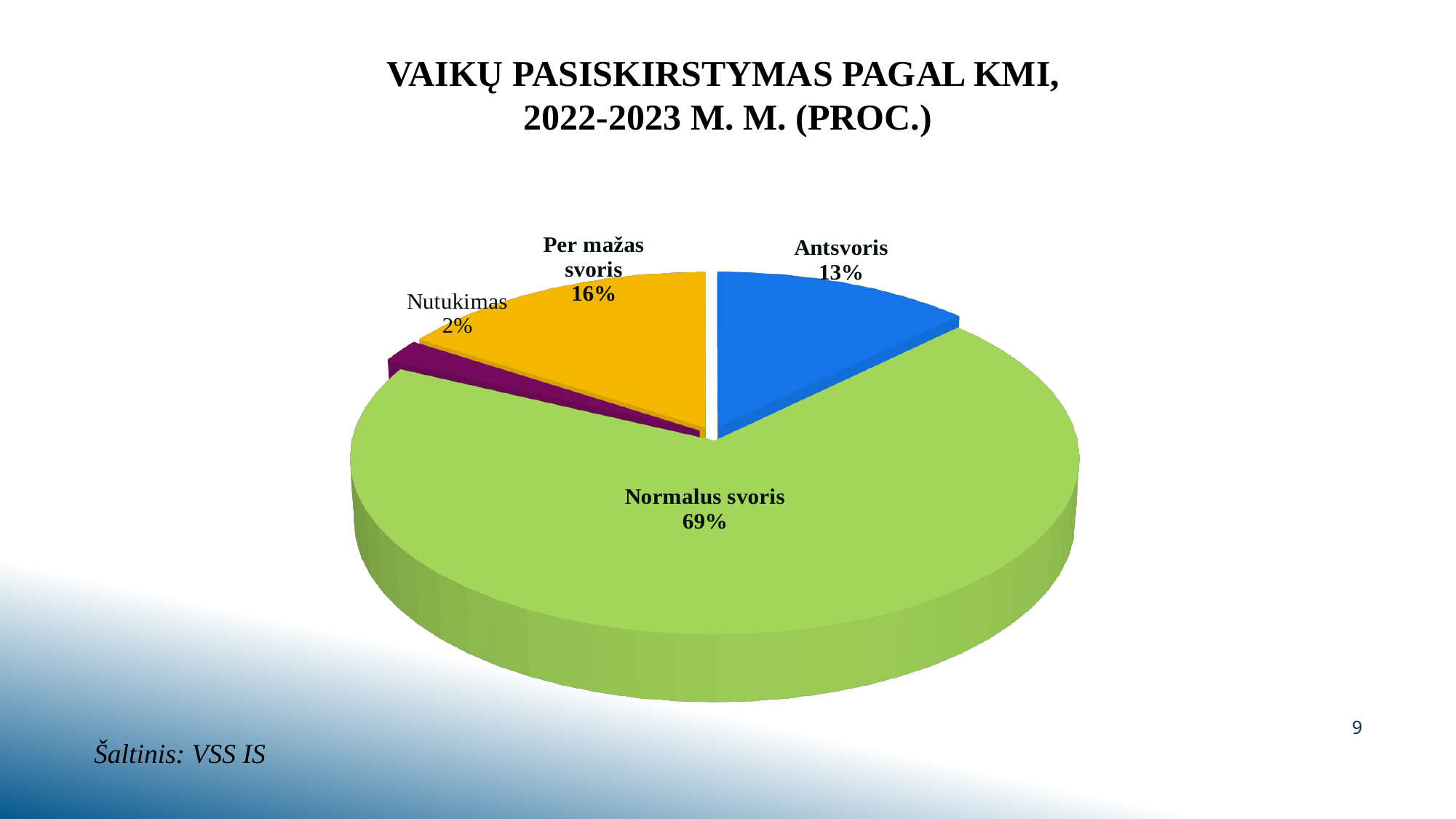
What percentage of children have normal weight (Normalus svoris)? 69% How many categories are shown in the pie chart? 4 Which category has the largest share of the pie? Normalus svoris Which category has the smallest share of the pie? Nutukimas What is the difference in percentage points between Per mažas svoris and Antsvoris? 3 What is the combined share of Antsvoris and Nutukimas? 15% What kind of chart is shown on the slide? pie chart What is the value for Nutukimas? 2% What is the value for Per mažas svoris? 16% What is the value for Antsvoris? 13% Which is larger, the share for Antsvoris or the share for Per mažas svoris? Per mažas svoris What is the title of the chart? VAIKŲ PASISKIRSTYMAS PAGAL KMI, 2022-2023 M. M. (PROC.)